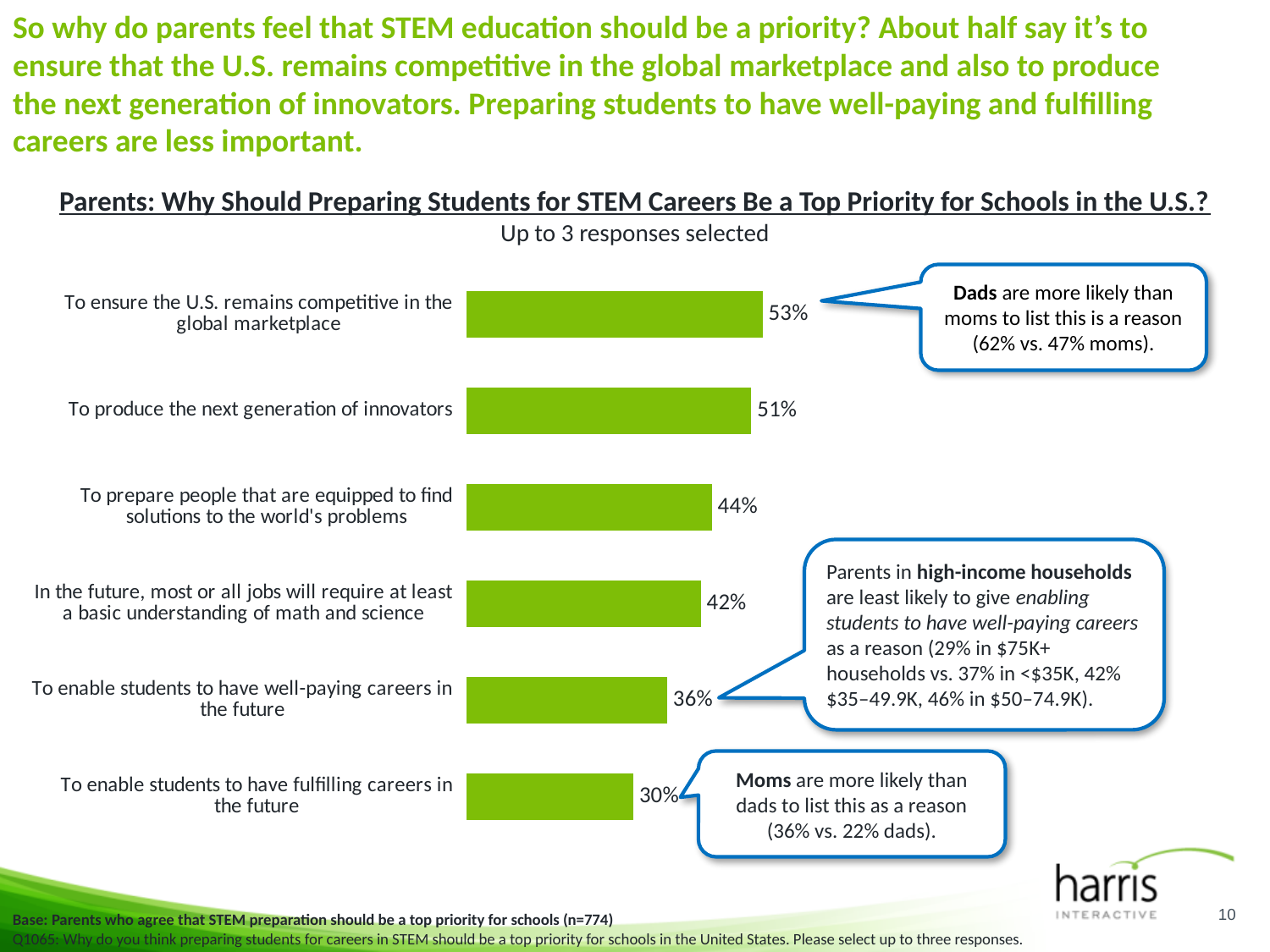
How many reasons are shown in the chart? 6 Which reason has the highest percentage? To ensure the U.S. remains competitive in the global marketplace What is the base size (n) for the chart? n=774 What is the difference in percentage points between "To prepare people that are equipped to find solutions to the world's problems" and "To enable students to have fulfilling careers in the future"? 14 What type of chart is shown on the slide? Bar chart What percentage of parents selected "To enable students to have well-paying careers in the future"? 36% Which reason has the lowest percentage? To enable students to have fulfilling careers in the future What percentage of parents selected "To ensure the U.S. remains competitive in the global marketplace"? 53% What is the title of the chart? Parents: Why Should Preparing Students for STEM Careers Be a Top Priority for Schools in the U.S.? What percentage of parents selected "To produce the next generation of innovators"? 51% What percentage of parents selected "In the future, most or all jobs will require at least a basic understanding of math and science"? 42% Which has a higher percentage: "To produce the next generation of innovators" or "To enable students to have well-paying careers in the future"? To produce the next generation of innovators